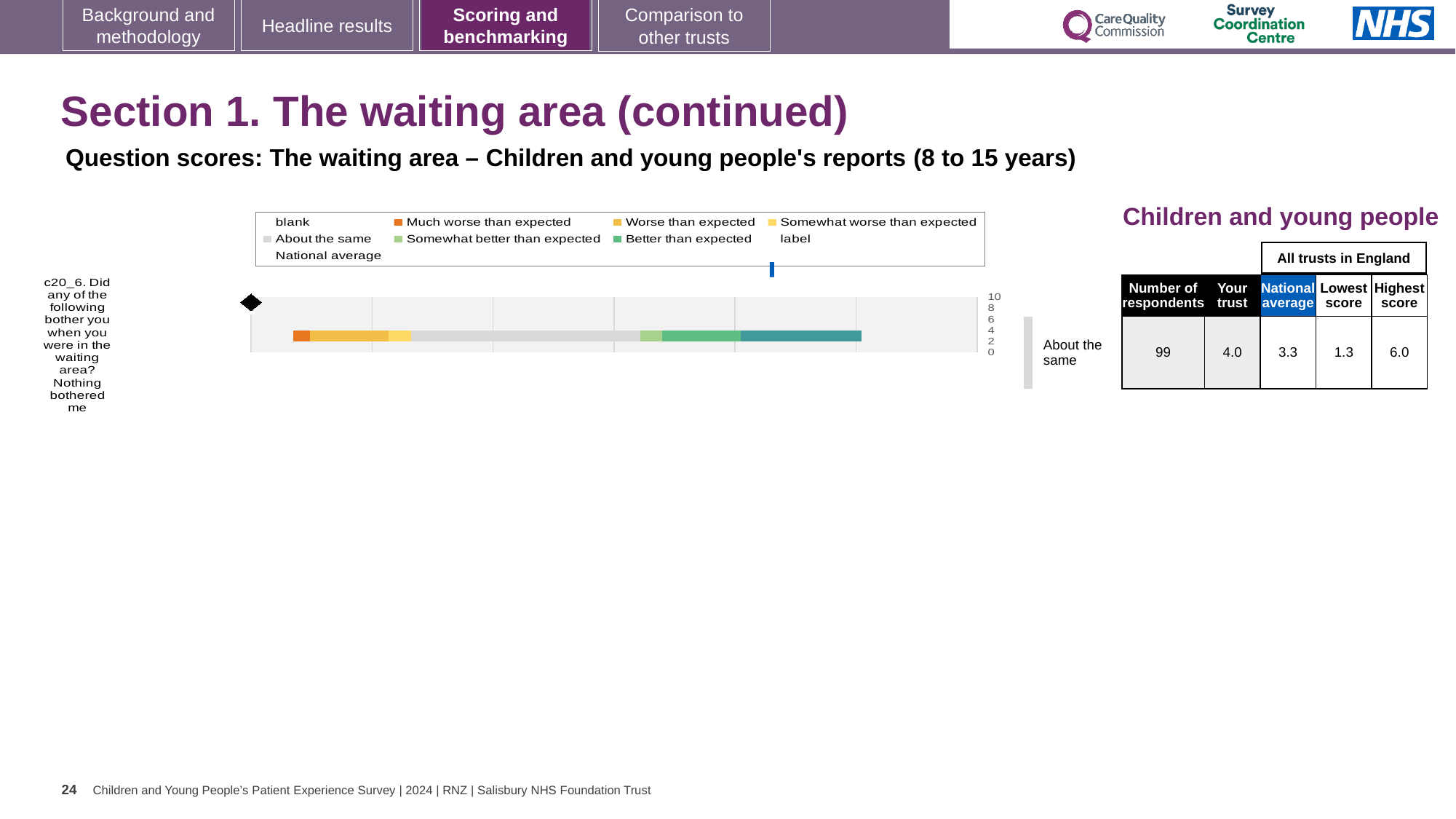
What is the national average score for question c20_6 in the table? 3.3 Which is larger for question c20_6: the 'Your trust' score or the national average? Your trust How many respondents answered question c20_6? 99 Which benchmark category is shown to the right of the bar for question c20_6? About the same How many survey questions are plotted in the chart? 1 By how much does the 'Your trust' score exceed the national average for question c20_6? 0.7 What is the 'Your trust' score for question c20_6 in the table? 4.0 Which legend entry is shown in orange? Much worse than expected What is the highest score among all trusts in England for question c20_6? 6.0 What is the difference between the highest score and the lowest score for question c20_6? 4.7 What kind of chart is shown on the slide? bar chart What is the lowest score among all trusts in England for question c20_6? 1.3